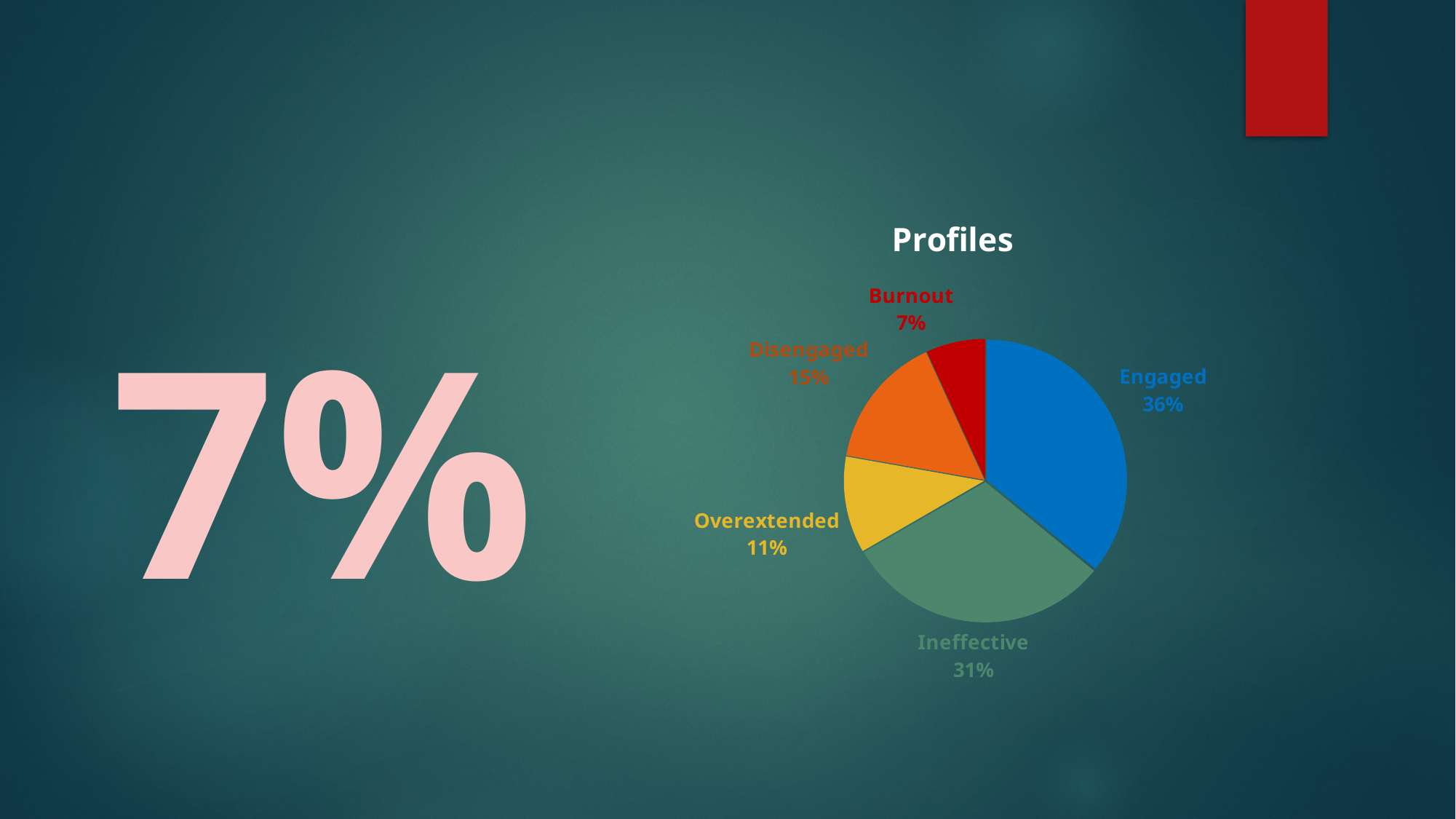
What percentage of the pie is the Burnout slice? 7% What kind of chart is shown on the slide? Pie chart What percentage of the pie is the Engaged slice? 36% What percentage of the pie is the Ineffective slice? 31% What percentage of the pie is the Disengaged slice? 15% How many slices does the pie chart have? 5 What is the difference in percentage points between the Engaged and Ineffective slices? 5 Which slice is larger, Disengaged or Overextended? Disengaged What is the title of the chart? Profiles Which profile has the smallest share of the pie? Burnout Which profile has the largest share of the pie? Engaged What percentage of the pie is the Overextended slice? 11%